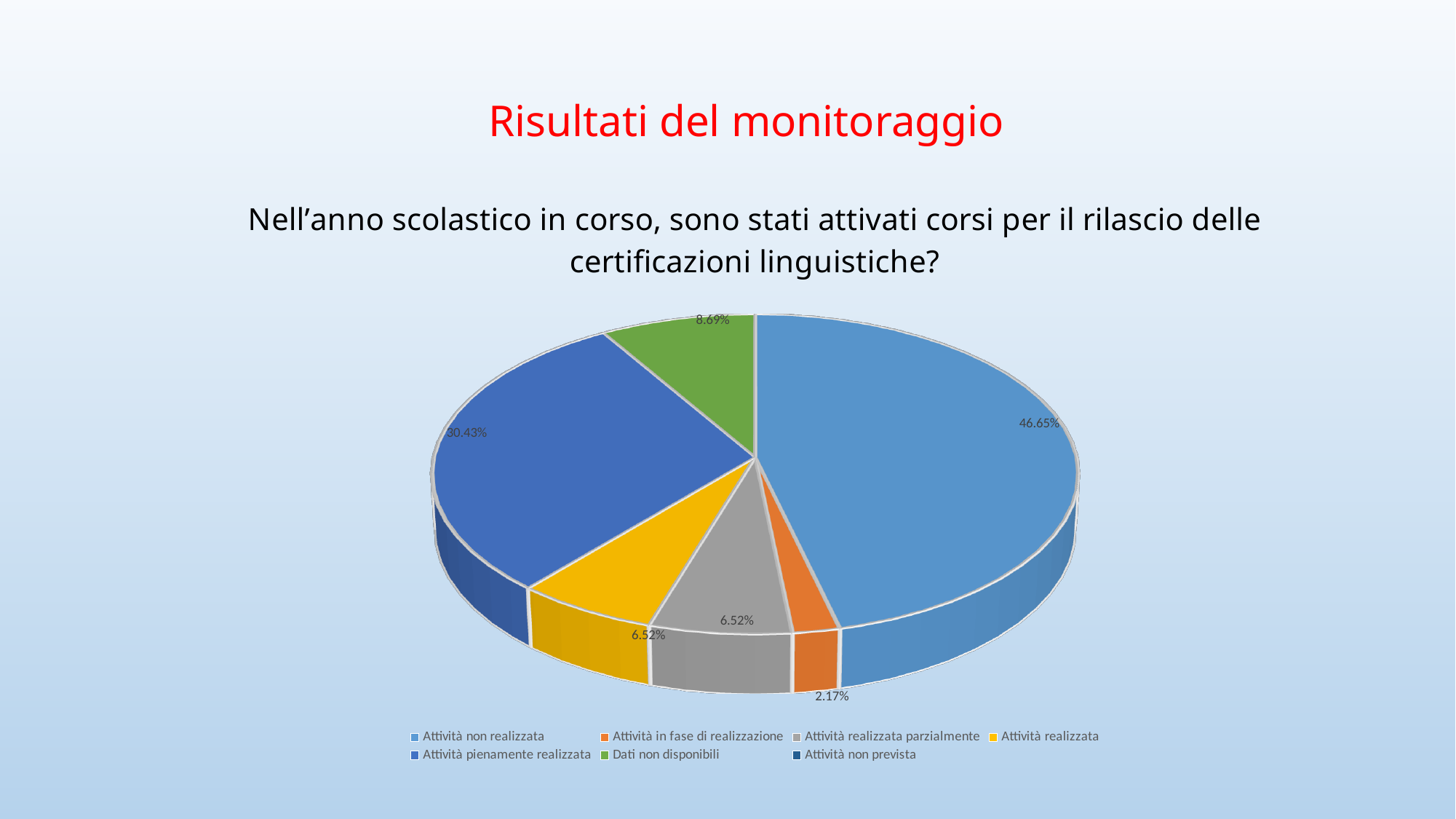
What is the title of the chart? Nell'anno scolastico in corso, sono stati attivati corsi per il rilascio delle certificazioni linguistiche? What kind of chart is shown on the slide? pie chart What percentage of the pie is 'Attività realizzata parzialmente'? 6.52% What percentage of the pie is 'Attività non realizzata'? 46.65% What percentage of the pie is 'Attività in fase di realizzazione'? 2.17% What percentage of the pie is 'Dati non disponibili'? 8.69% Which category has the largest slice of the pie? Attività non realizzata How many entries does the legend list? 7 What percentage of the pie is 'Attività pienamente realizzata'? 30.43% Which labelled slice is the smallest in the pie? Attività in fase di realizzazione What is the difference in percentage points between 'Attività non realizzata' and 'Attività pienamente realizzata'? 16.22 Which is larger: 'Dati non disponibili' or 'Attività realizzata'? Dati non disponibili